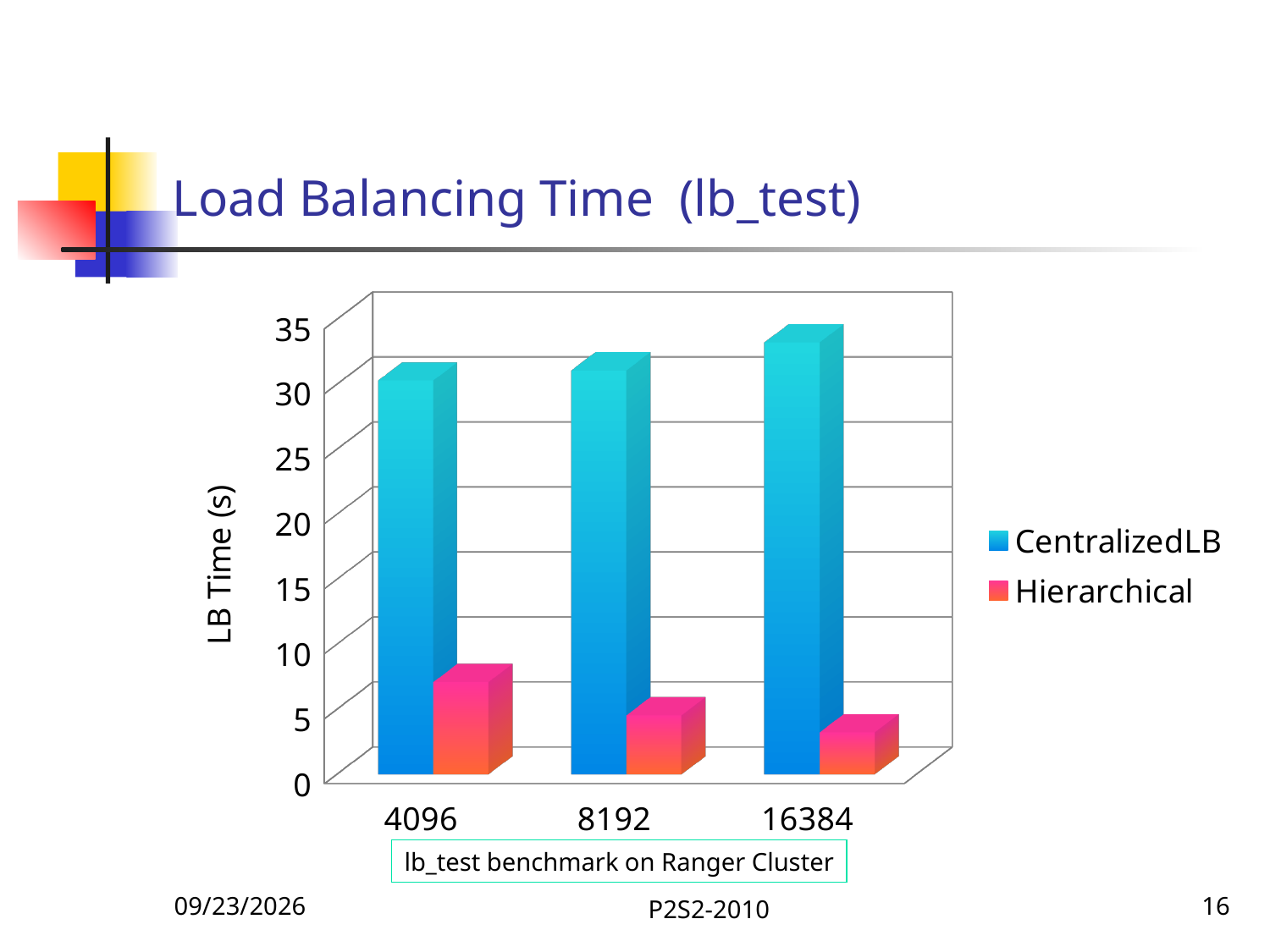
At 8192, which series has the larger value, CentralizedLB or Hierarchical? CentralizedLB Is the CentralizedLB value for 4096 greater or less than 25? greater What is the label of the y axis? LB Time (s) Which series is shown in blue in the legend? CentralizedLB For which category is the CentralizedLB value highest? 16384 How many categories are shown on the x axis? 3 Do the Hierarchical values rise or fall as the x axis goes from 4096 to 16384? fall How many series does the legend list? 2 For which category is the Hierarchical value lowest? 16384 What kind of chart is shown on the slide? bar chart Do the CentralizedLB values rise or fall as the x axis goes from 4096 to 16384? rise Is the Hierarchical value for 4096 greater or less than 10? less